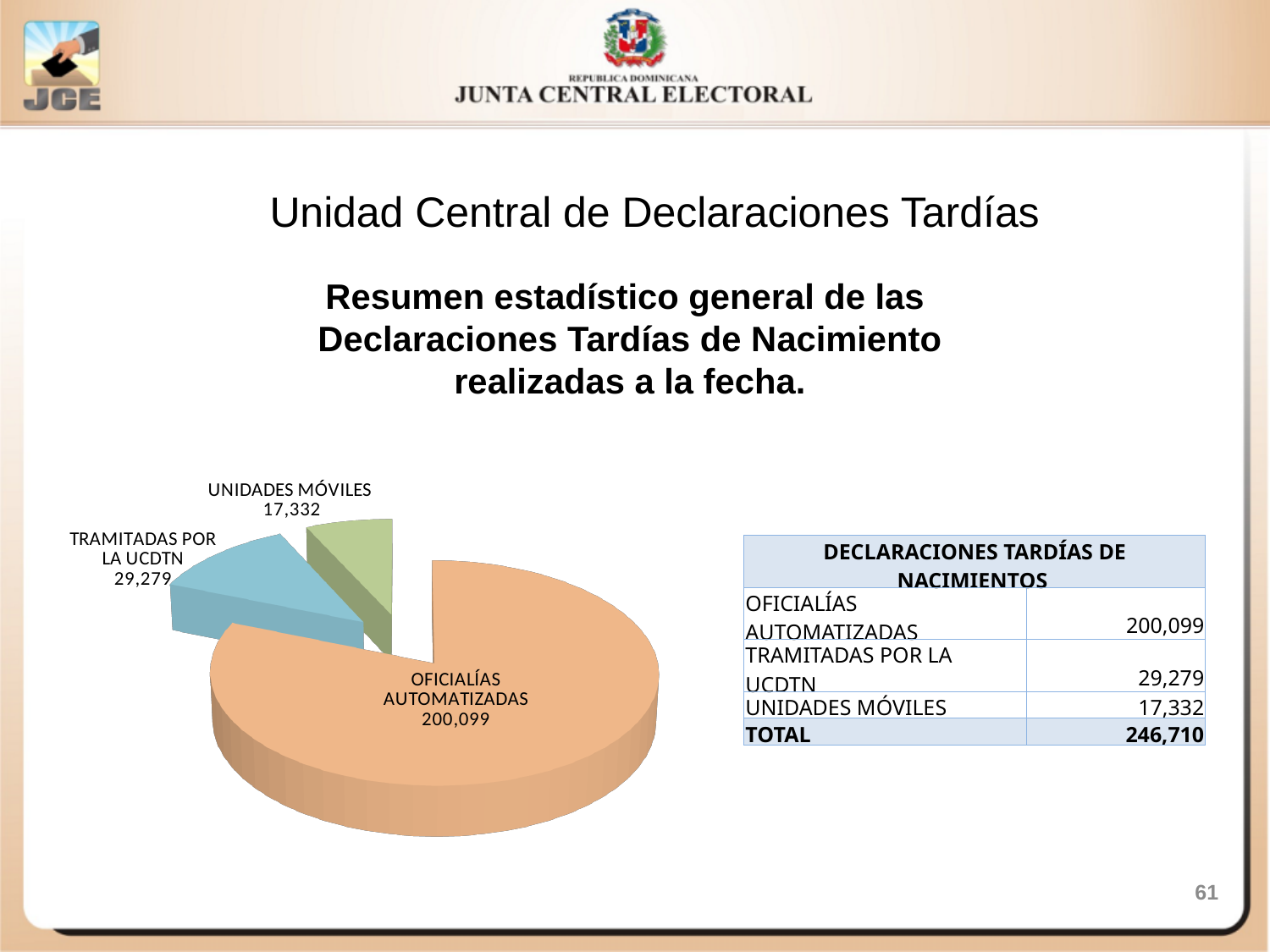
What is the value for UNIDADES MÓVILES in the pie chart? 17,332 What is the difference between the values for TRAMITADAS POR LA UCDTN and UNIDADES MÓVILES? 11,947 What is the value for OFICIALÍAS AUTOMATIZADAS in the pie chart? 200,099 What is the value for TRAMITADAS POR LA UCDTN in the pie chart? 29,279 Which category has the smallest slice in the pie chart? UNIDADES MÓVILES What colour is the OFICIALÍAS AUTOMATIZADAS slice in the pie chart? Orange How many slices does the pie chart have? 3 Which is larger in the pie chart, TRAMITADAS POR LA UCDTN or UNIDADES MÓVILES? TRAMITADAS POR LA UCDTN Which category has the largest slice in the pie chart? OFICIALÍAS AUTOMATIZADAS What kind of chart is shown on the slide? Pie chart What is the total of all three slices in the pie chart, as shown in the table? 246,710 What is the difference between the values for OFICIALÍAS AUTOMATIZADAS and TRAMITADAS POR LA UCDTN? 170,820